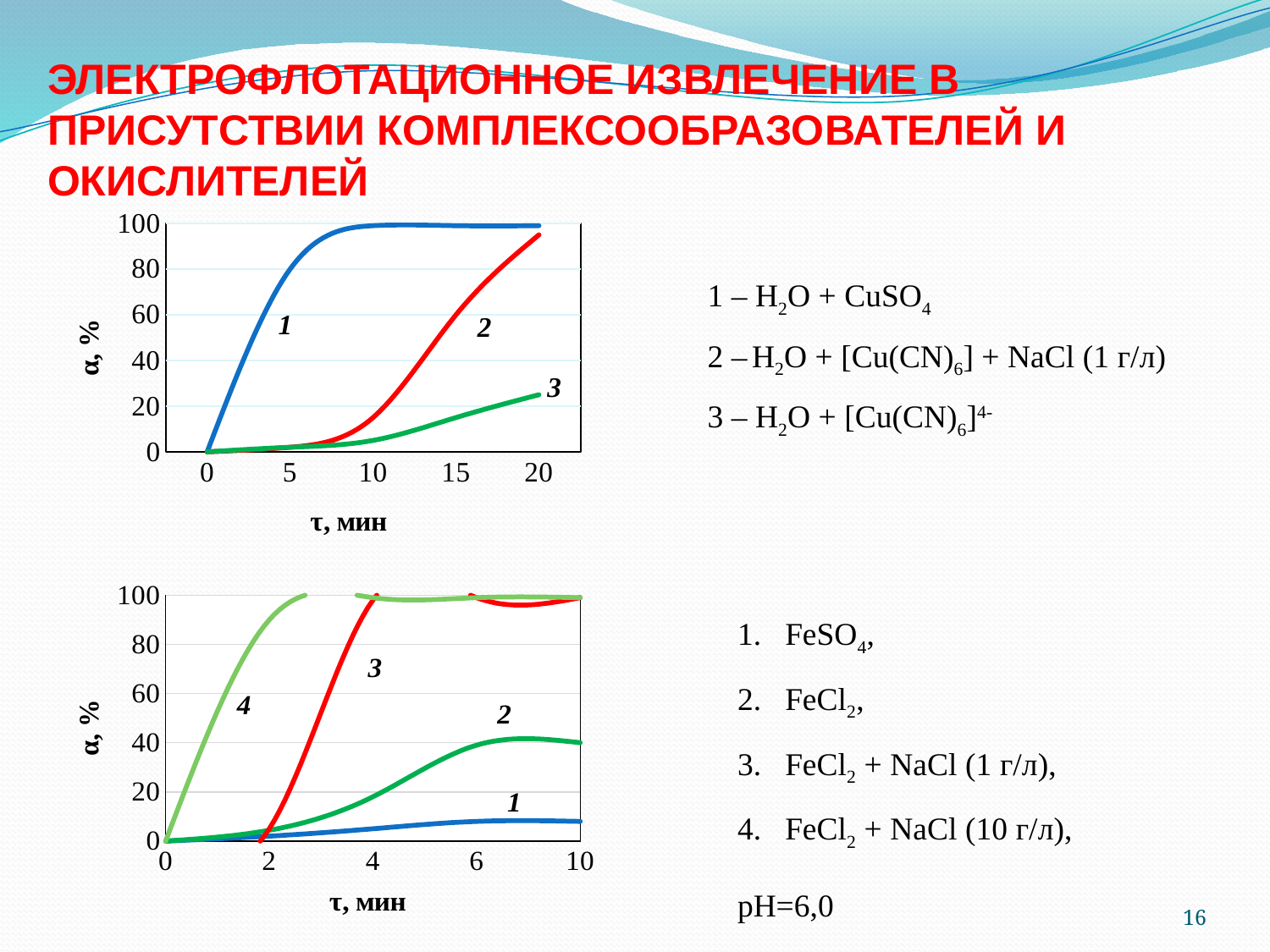
In the bottom chart, at τ = 10 min, which is larger: curve 2 or curve 1? curve 2 What is the label of the x axis in the bottom chart? τ, мин In the top chart, is the value of curve 2 at τ = 10 min greater or less than 40? less In the bottom chart, is the value of curve 4 at τ = 2 min greater or less than 60? greater In the top chart, is the value of curve 3 at τ = 20 min greater or less than 40? less How many curves are plotted in the bottom chart? 4 What type of chart is the top chart on the slide? line chart How many curves are plotted in the top chart? 3 In the top chart, which curve has the lowest value at τ = 20 min? curve 3 In the bottom chart, which curve reaches 100% first? curve 4